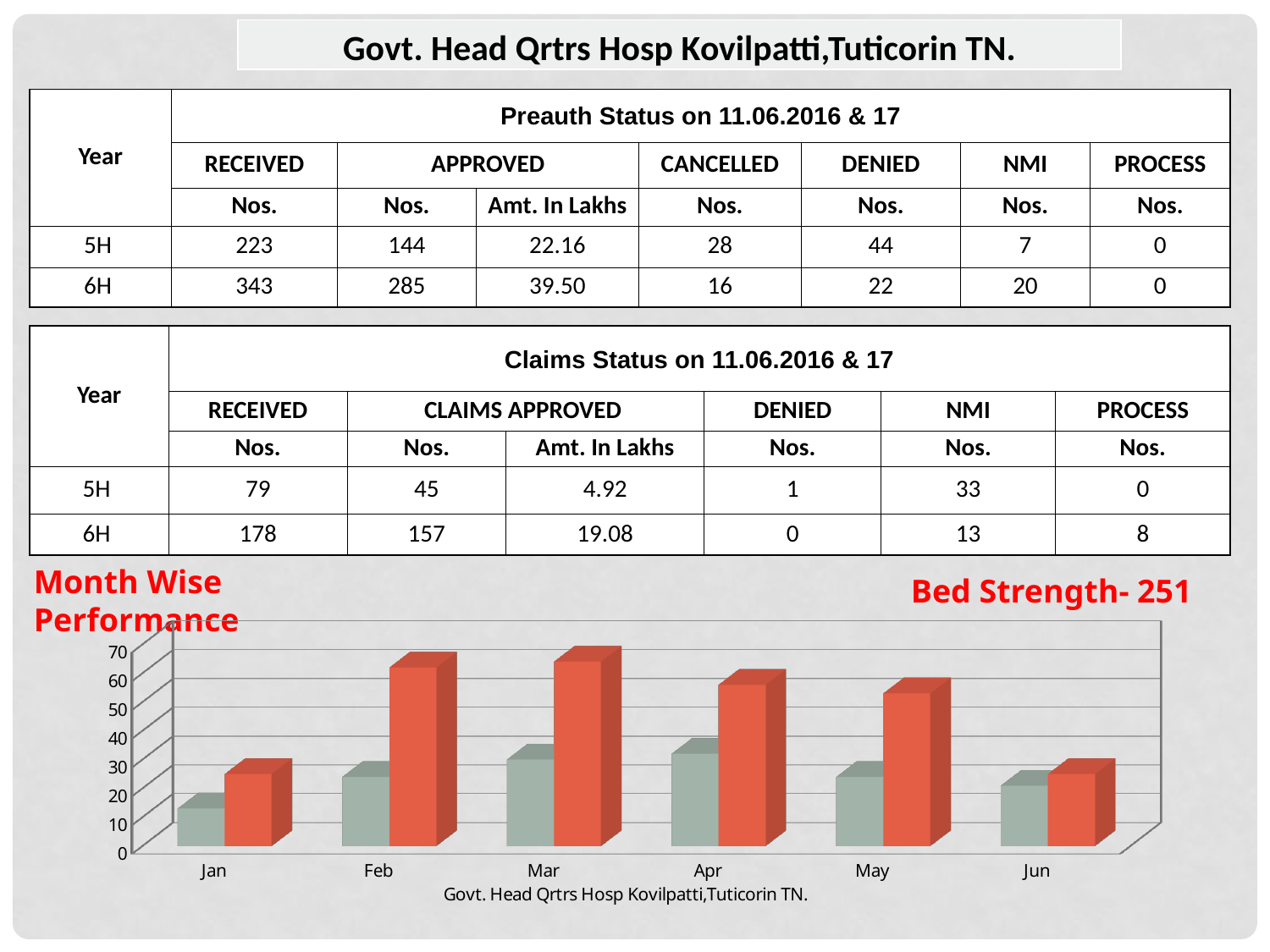
What kind of chart is shown at the bottom of the slide? bar chart In the Month Wise Performance chart, is the red bar for Feb greater or less than 50? greater In the Month Wise Performance chart, is the grey bar for Apr greater or less than 20? greater In the Month Wise Performance chart, is the red bar for Feb or the red bar for Jun taller? Feb In the Month Wise Performance chart, is the red bar for Jun greater or less than 40? less In the Month Wise Performance chart, for Feb, is the grey bar or the red bar taller? red In the Month Wise Performance chart, which month has the lowest grey bar? Jan How many bars are plotted for each month in the Month Wise Performance chart? 2 What text appears below the x axis of the Month Wise Performance chart? Govt. Head Qrtrs Hosp Kovilpatti,Tuticorin TN. What is the highest value shown on the vertical axis of the Month Wise Performance chart? 70 How many months are shown on the x axis of the Month Wise Performance chart? 6